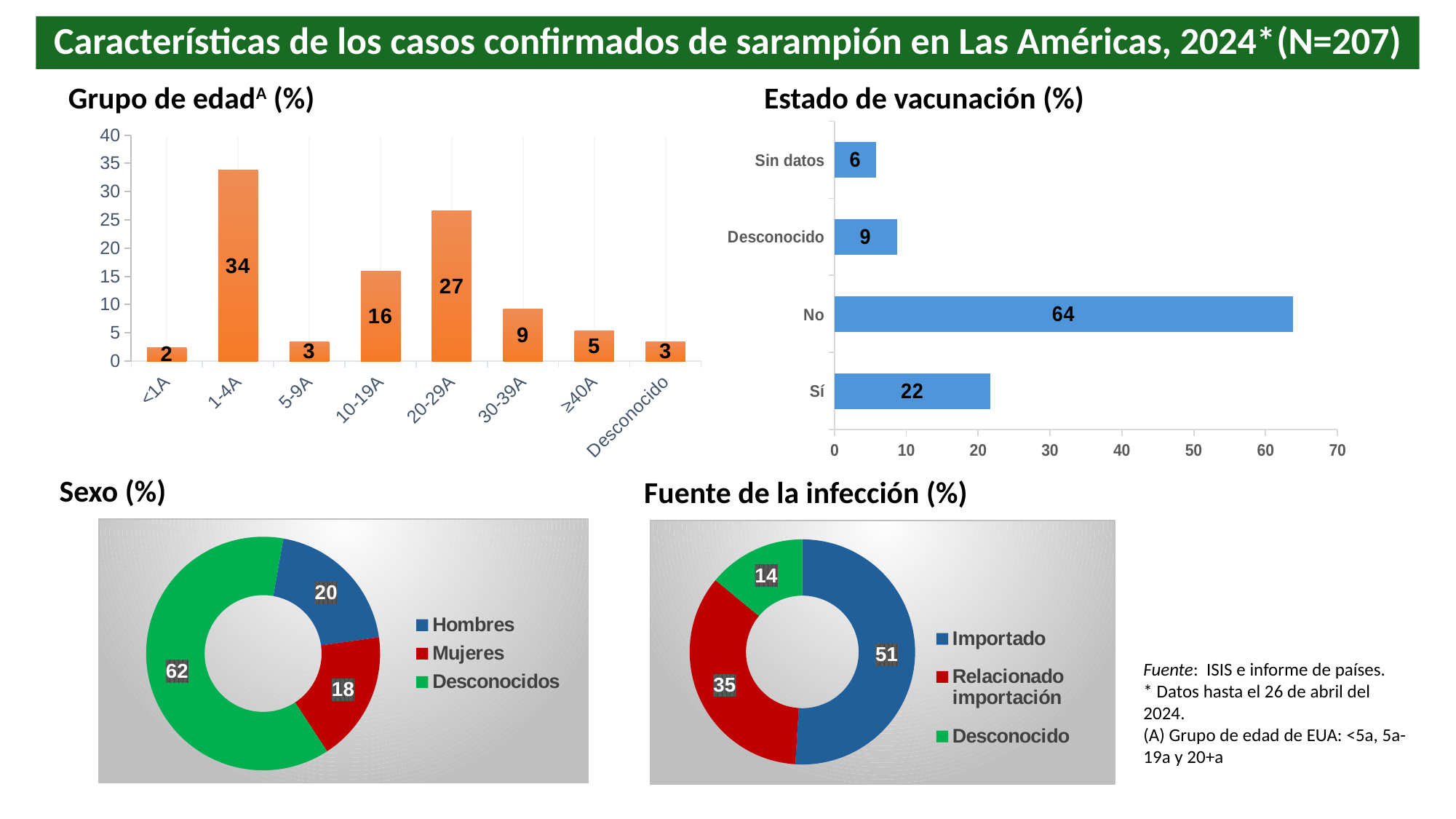
What kind of chart is the 'Estado de vacunación (%)' chart? Bar chart In the 'Grupo de edad (%)' chart, which age group has the highest value? 1-4A In the 'Estado de vacunación (%)' chart, what is the value for 'No'? 64 In the 'Estado de vacunación (%)' chart, which category has the lowest value? Sin datos In the 'Estado de vacunación (%)' chart, which is larger, 'Sí' or 'Desconocido'? Sí In the 'Grupo de edad (%)' chart, how many age group categories are shown? 8 In the 'Grupo de edad (%)' chart, what is the value for the 1-4A age group? 34 In the 'Grupo de edad (%)' chart, what is the difference between the values for 20-29A and 10-19A? 11 How many entries does the legend of the 'Fuente de la infección (%)' chart list? 3 In the 'Grupo de edad (%)' chart, which age group has the lowest value? <1A In the 'Sexo (%)' chart, what is the value for Mujeres? 18 In the 'Fuente de la infección (%)' chart, what is the value for Importado? 51